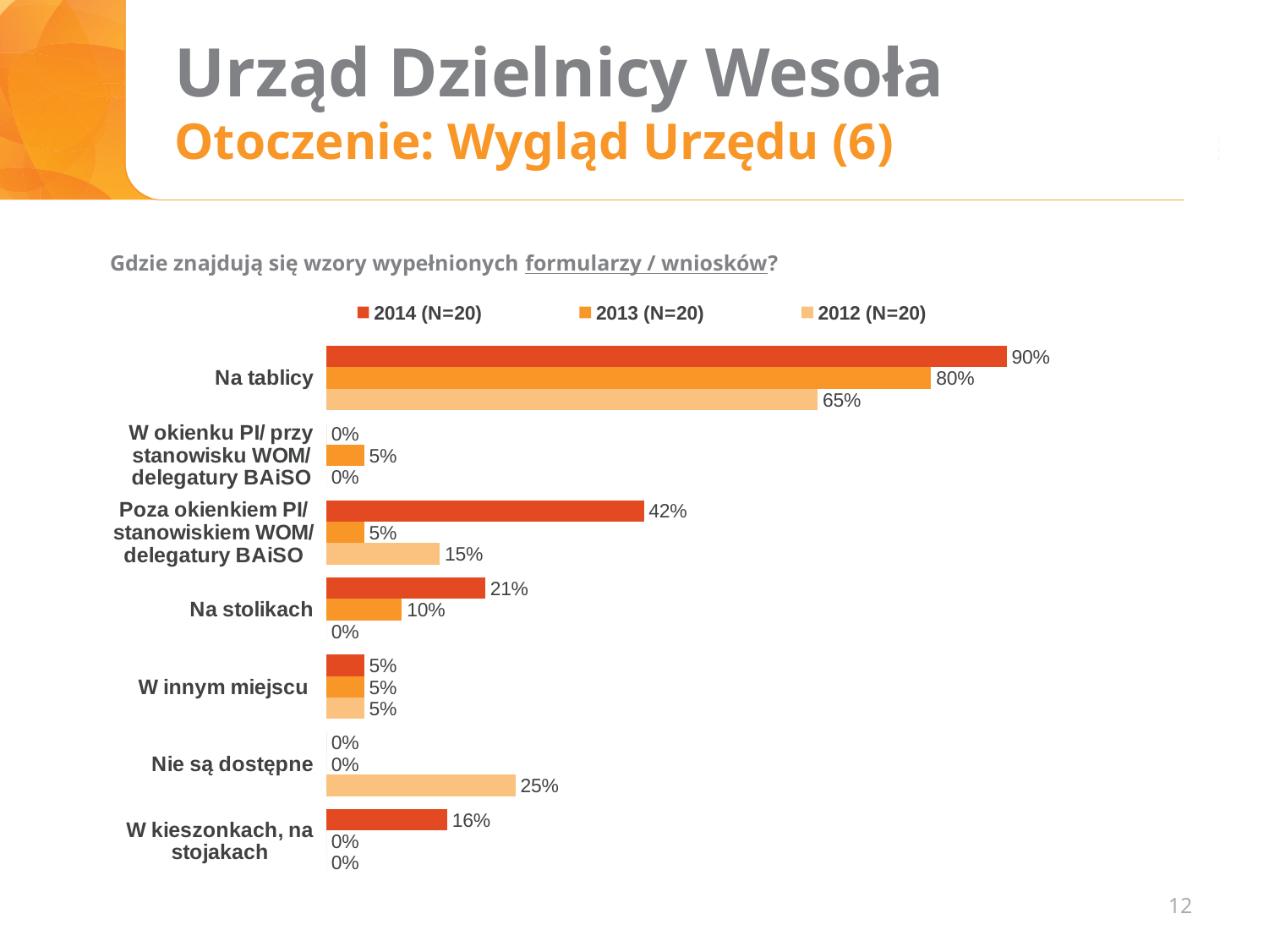
What is the value for "Na tablicy" in the 2014 (N=20) series? 90% What is the total of the three series values for "W innym miejscu"? 15% What kind of chart is shown on the slide? bar chart How many series does the legend list? 3 What is the value for "Na stolikach" in the 2013 (N=20) series? 10% What is the value for "Nie są dostępne" in the 2012 (N=20) series? 25% What question is the chart about, as written above it? Gdzie znajdują się wzory wypełnionych formularzy / wniosków? What is the difference between the 2014 (N=20) and 2012 (N=20) values for "Na tablicy"? 25% Which is larger for "W kieszonkach, na stojakach": the 2014 (N=20) value or the 2013 (N=20) value? 2014 (N=20) What is the value for "Poza okienkiem PI/ stanowiskiem WOM/ delegatury BAiSO" in the 2014 (N=20) series? 42% Which category has the highest value in the 2012 (N=20) series? Na tablicy How many categories are shown on the chart? 7